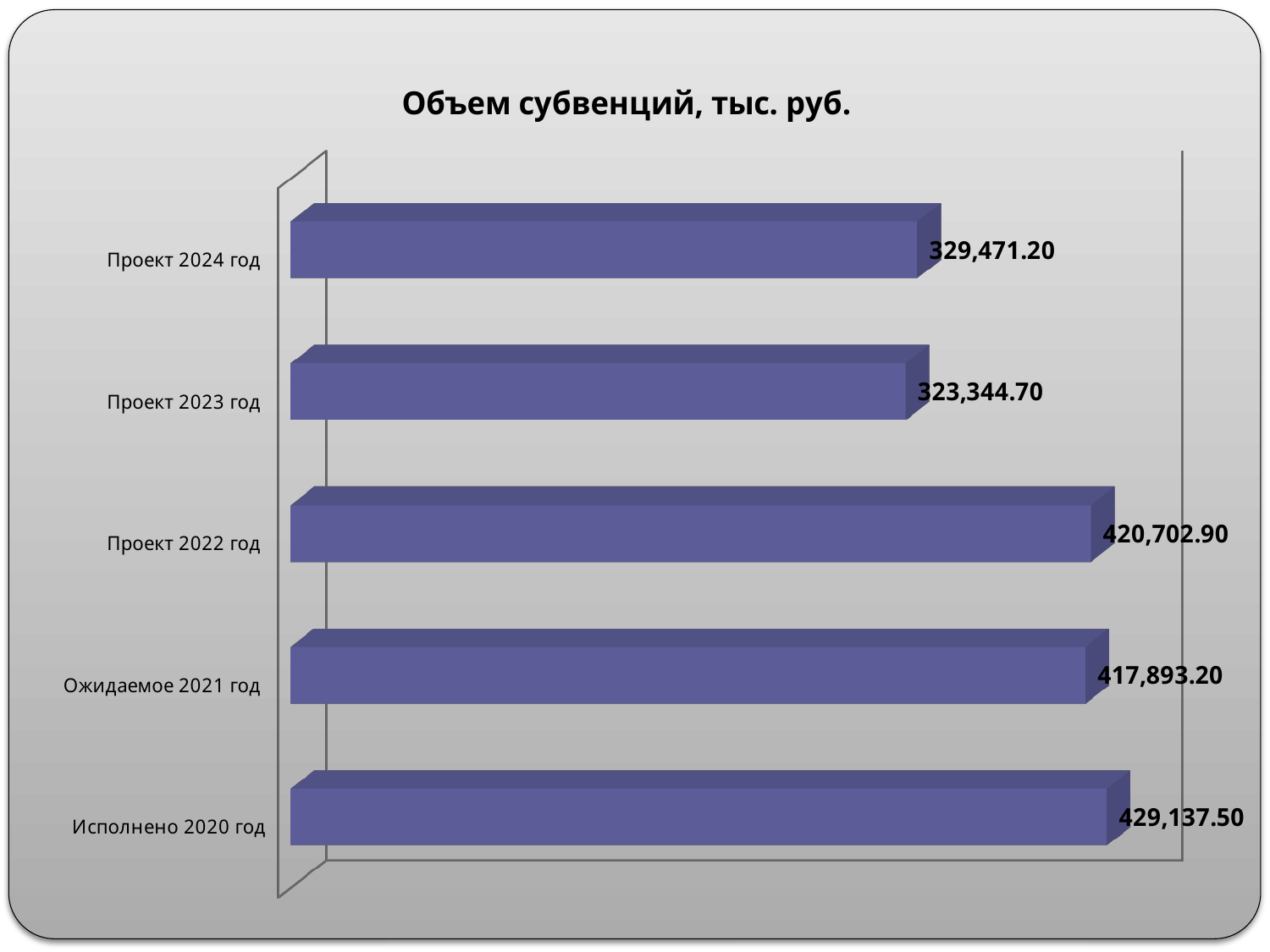
Which is larger, the value for Проект 2022 год or the value for Проект 2023 год? Проект 2022 год What is the value for Проект 2024 год? 329,471.20 What is the value for Ожидаемое 2021 год? 417,893.20 What is the difference between the values for Исполнено 2020 год and Проект 2024 год? 99,666.30 What kind of chart is shown on the slide? Bar chart Which category has the lowest value? Проект 2023 год Which category has the highest value? Исполнено 2020 год What is the difference between the values for Исполнено 2020 год and Ожидаемое 2021 год? 11,244.30 How many categories are shown in the chart? 5 What is the title of the chart? Объем субвенций, тыс. руб. What is the value for Проект 2022 год? 420,702.90 What is the difference between the values for Проект 2024 год and Проект 2023 год? 6,126.50